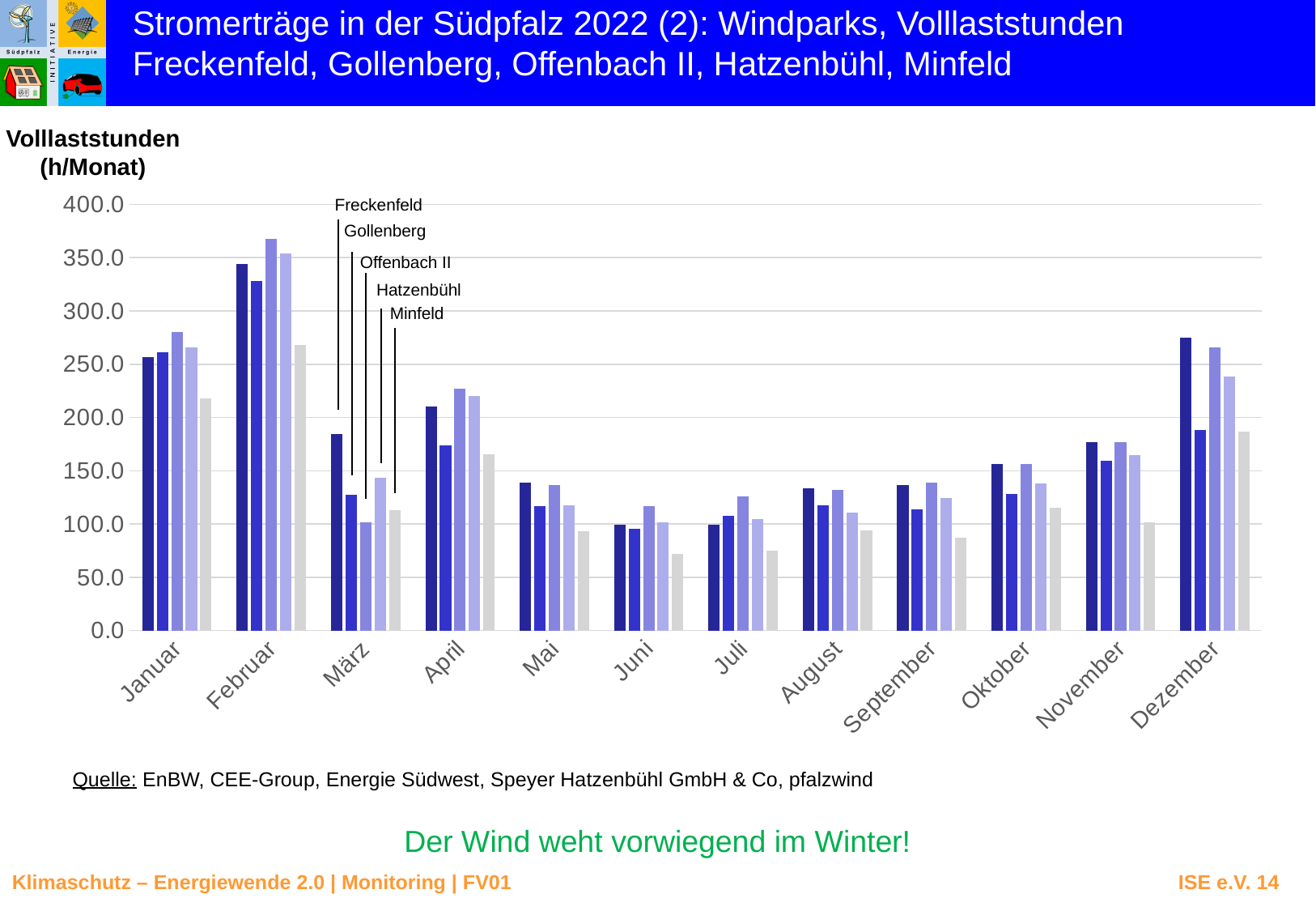
Do the values for Freckenfeld rise or fall from Februar to Juni? fall What kind of chart is shown on the slide? bar chart How many wind parks (series) does the chart's legend list? 5 Is the value for Freckenfeld in Februar greater or less than 300? greater In which month does Offenbach II reach its highest value? Februar What unit is given for the y axis of the chart? h/Monat Is the value for Minfeld in Juni greater or less than 100? less In Januar, which wind park has the lowest value? Minfeld How many months are shown along the x axis of the chart? 12 Is the value for Minfeld in Januar greater or less than 200? greater Which is larger: the value for Freckenfeld in Februar or in Dezember? Februar